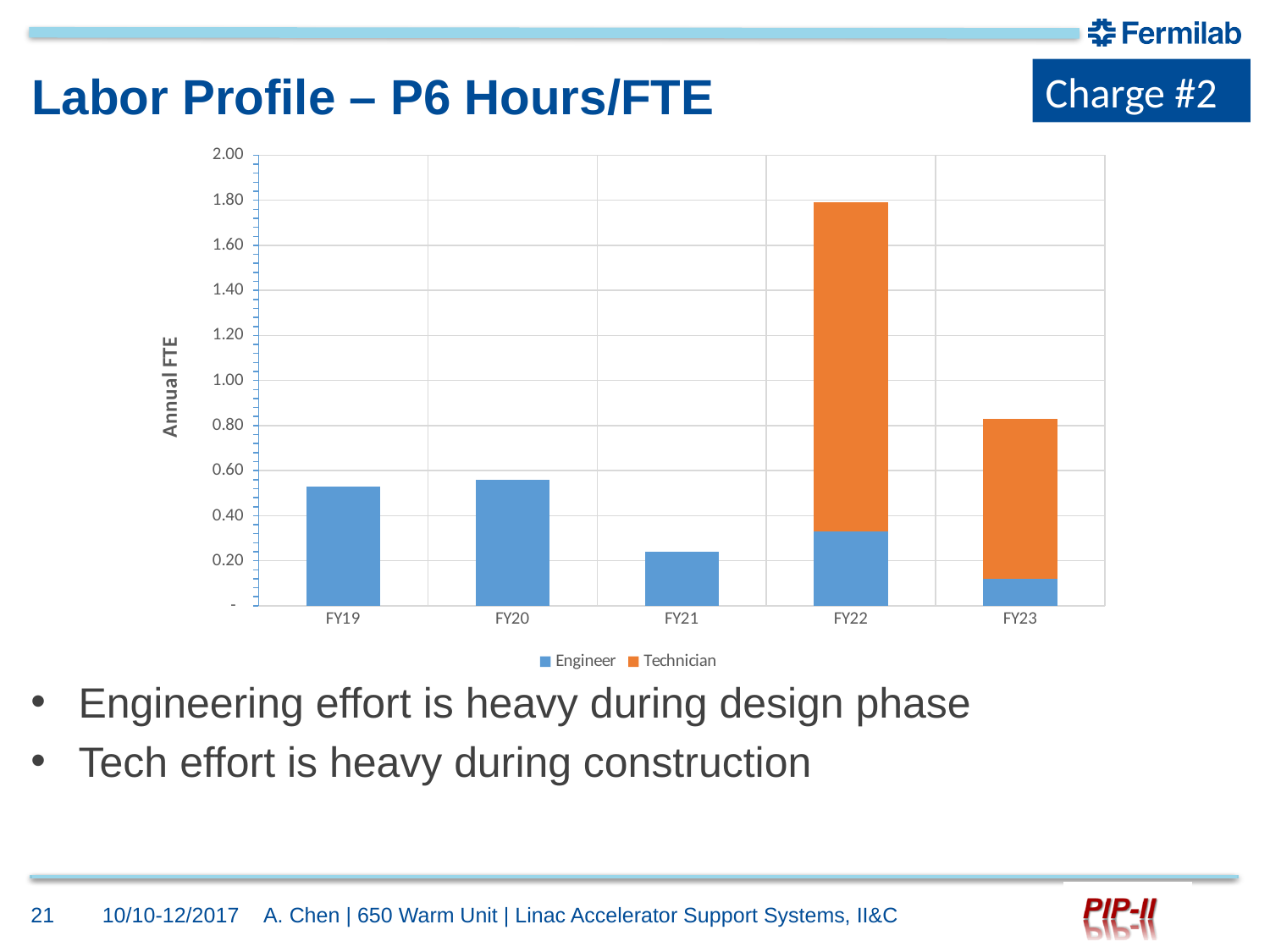
What is the title of the chart's vertical axis? Annual FTE What kind of chart is shown on the slide? Stacked bar chart Is the total Annual FTE for FY23 greater or less than 1.00? less Which fiscal year has the lowest total Annual FTE? FY21 How many fiscal years are shown on the x axis of the chart? 5 Which fiscal year has the highest total Annual FTE? FY22 How many series does the chart's legend list? 2 Is the total Annual FTE for FY22 greater or less than 1.60? greater Which fiscal year has the lowest Engineer FTE? FY23 Which has the larger total Annual FTE, FY22 or FY23? FY22 Is the Engineer FTE for FY21 greater or less than 0.40? less